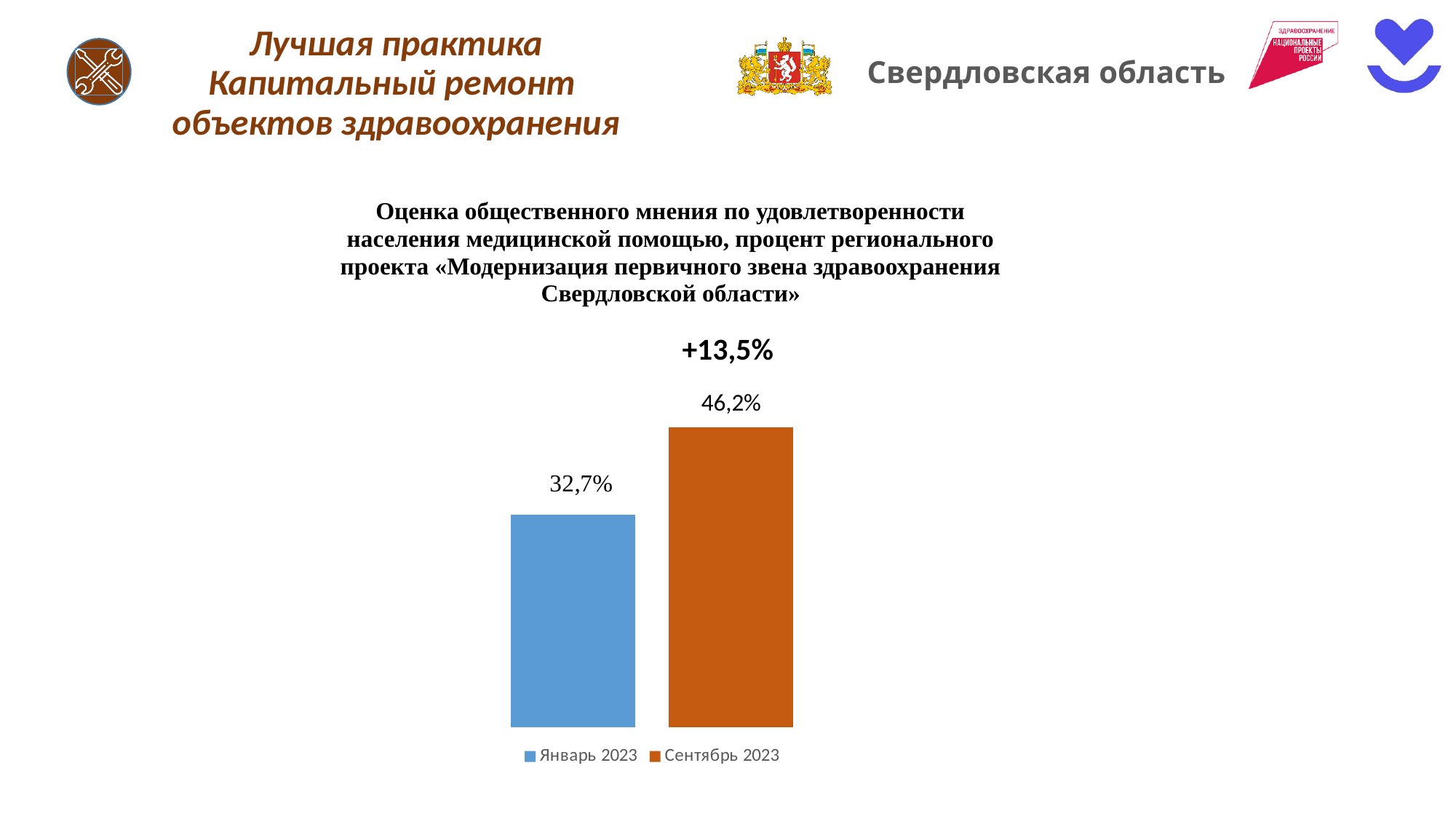
What is the difference between the Сентябрь 2023 value and the Январь 2023 value? 13,5% Which series has the lowest value? Январь 2023 How many series does the legend list? 2 What is the value for Январь 2023? 32,7% How many bars are plotted in the chart? 2 What change is annotated above the bars in the chart? +13,5% Which series has the higher value, Январь 2023 or Сентябрь 2023? Сентябрь 2023 Which series has the highest value? Сентябрь 2023 Do the values rise or fall from Январь 2023 to Сентябрь 2023? rise What is the value for Сентябрь 2023? 46,2% What kind of chart is shown on the slide? bar chart What colour is the bar for Сентябрь 2023? orange